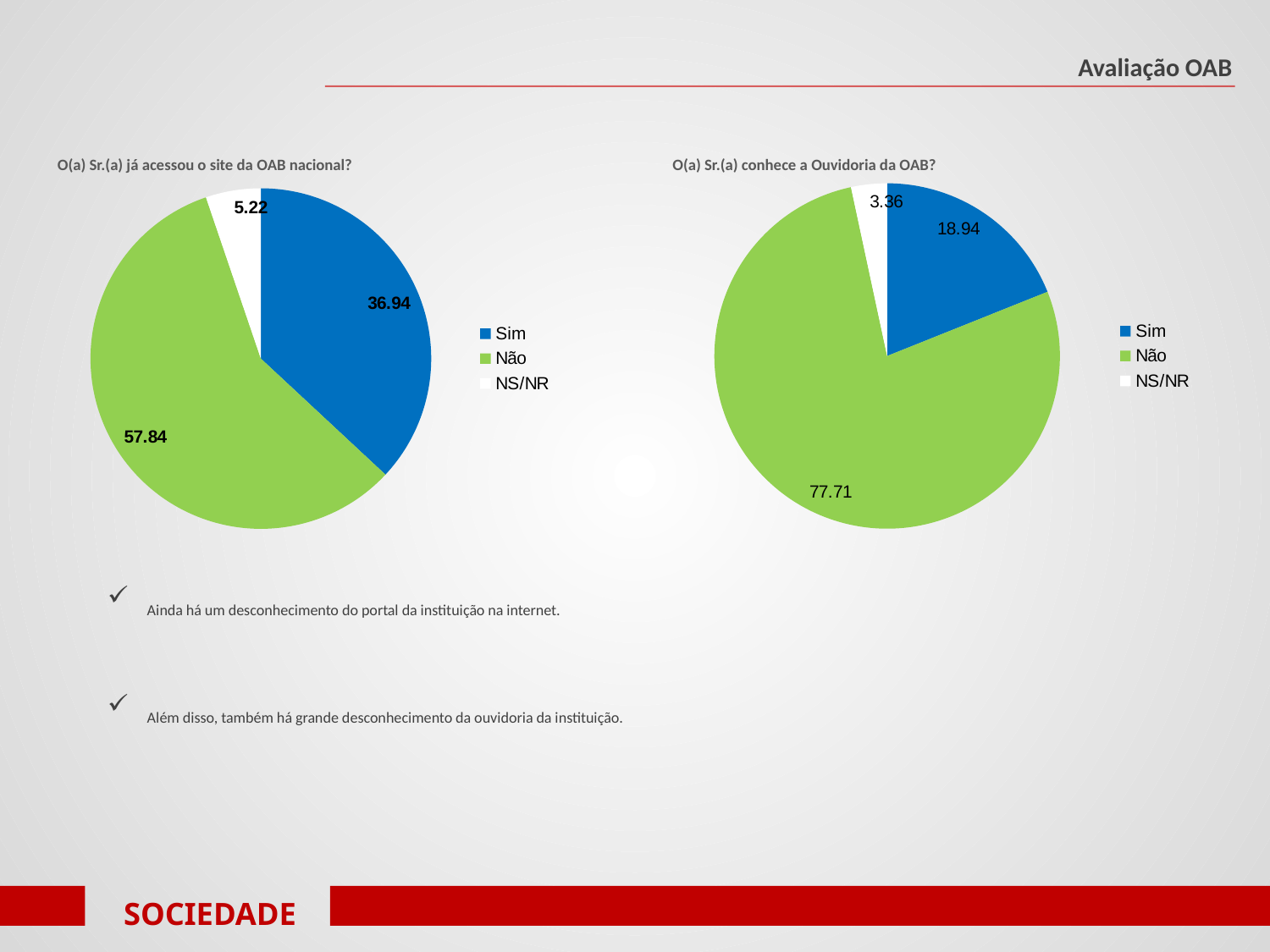
In the left pie chart 'O(a) Sr.(a) já acessou o site da OAB nacional?', what is the difference between the values for Não and Sim? 20.90 In the right pie chart 'O(a) Sr.(a) conhece a Ouvidoria da OAB?', which category has the smallest slice? NS/NR How many categories does the legend of the right pie chart 'O(a) Sr.(a) conhece a Ouvidoria da OAB?' list? 3 Which is larger: the value for Sim in the left pie chart or the value for Sim in the right pie chart? Left pie chart (36.94) In the right pie chart 'O(a) Sr.(a) conhece a Ouvidoria da OAB?', what is the value for NS/NR? 3.36 In the left pie chart 'O(a) Sr.(a) já acessou o site da OAB nacional?', what is the value for Não? 57.84 What type of chart is used on this slide? Pie chart In the right pie chart 'O(a) Sr.(a) conhece a Ouvidoria da OAB?', what is the value for Sim? 18.94 In the left pie chart 'O(a) Sr.(a) já acessou o site da OAB nacional?', what is the value for NS/NR? 5.22 In the left pie chart 'O(a) Sr.(a) já acessou o site da OAB nacional?', what is the value for Sim? 36.94 In the left pie chart 'O(a) Sr.(a) já acessou o site da OAB nacional?', which category has the largest slice? Não In the right pie chart 'O(a) Sr.(a) conhece a Ouvidoria da OAB?', what is the value for Não? 77.71